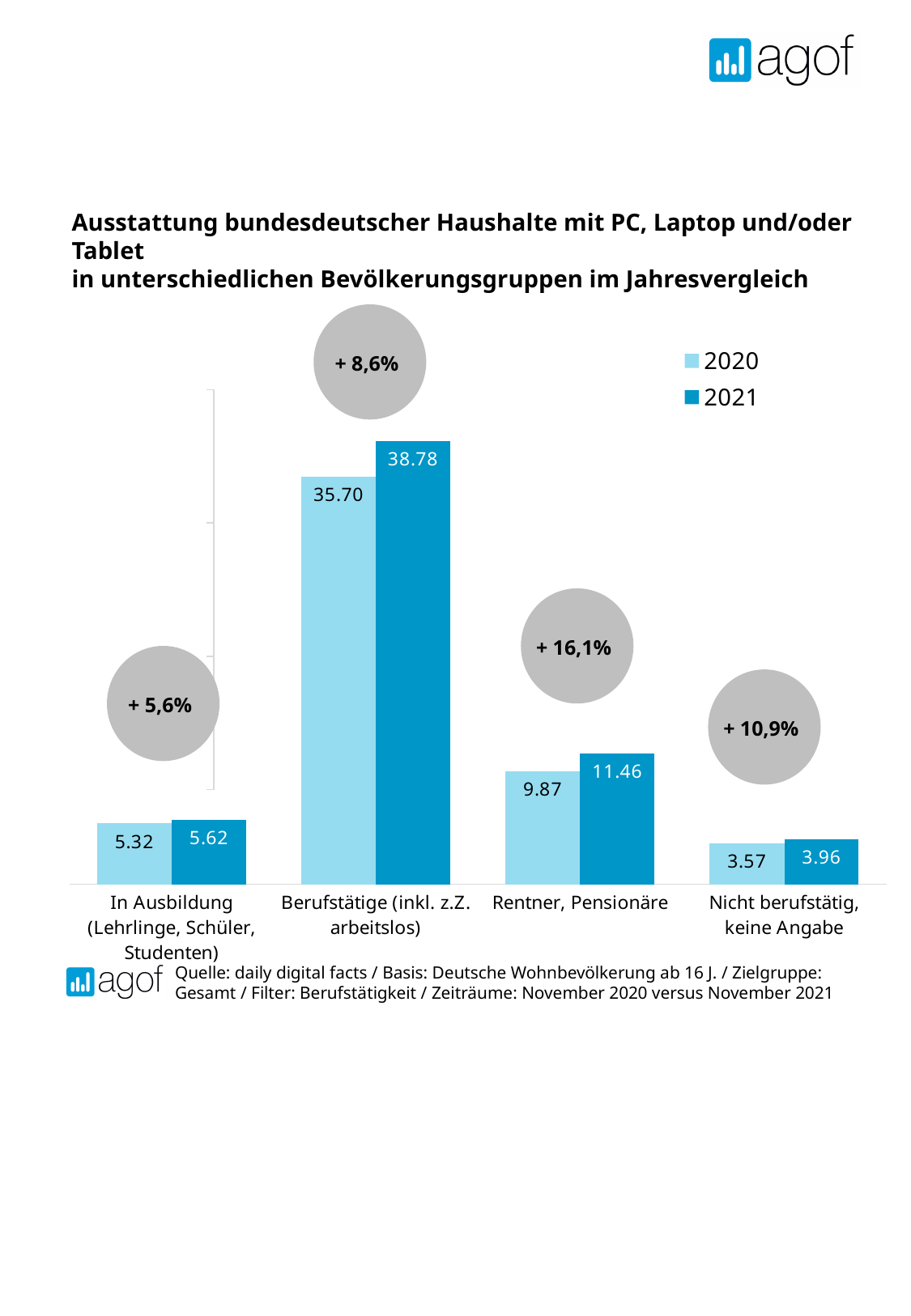
How many series does the legend list? 2 How many categories are shown on the x axis? 4 What is the difference between the 2021 and 2020 values for Berufstätige (inkl. z.Z. arbeitslos)? 3.08 What kind of chart is shown on the slide? Bar chart Which category has the highest 2021 value? Berufstätige (inkl. z.Z. arbeitslos) Which category has the lowest 2020 value? Nicht berufstätig, keine Angabe What is the 2021 value for In Ausbildung (Lehrlinge, Schüler, Studenten)? 5.62 Which is larger: the 2021 value for Rentner, Pensionäre or the 2021 value for In Ausbildung (Lehrlinge, Schüler, Studenten)? Rentner, Pensionäre What is the 2020 value for Rentner, Pensionäre? 9.87 What is the 2020 value for Nicht berufstätig, keine Angabe? 3.57 What percentage change is shown in the grey circle above Rentner, Pensionäre? + 16,1% What is the 2021 value for Berufstätige (inkl. z.Z. arbeitslos)? 38.78